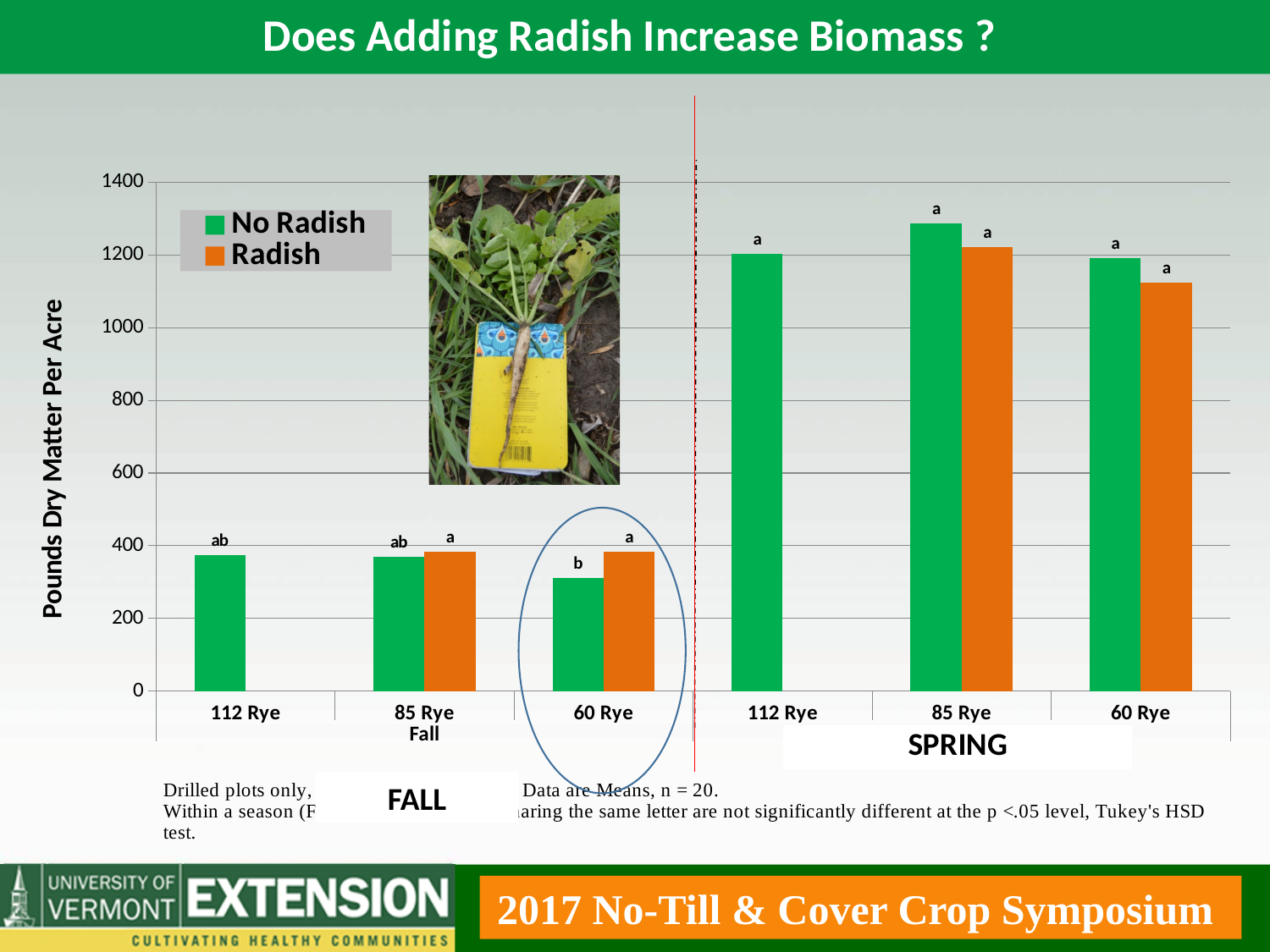
Is the No Radish value for 60 Rye in Fall greater or less than 400? less For 60 Rye in Fall, which is larger: the No Radish bar or the Radish bar? Radish Which colour represents the Radish series in the chart? orange What kind of chart is shown on the slide? bar chart Which bar in the chart is the lowest? No Radish, 60 Rye (Fall) Is the No Radish value for 85 Rye in Spring greater or less than 1200? greater Which bar in the chart is the highest? No Radish, 85 Rye (Spring) What is the label on the y axis of the chart? Pounds Dry Matter Per Acre Is the Radish value for 60 Rye in Spring greater or less than 1000? greater How many categories are shown along the x axis of the chart? 6 How many series does the chart legend list? 2 For 85 Rye in Spring, which is larger: the No Radish bar or the Radish bar? No Radish